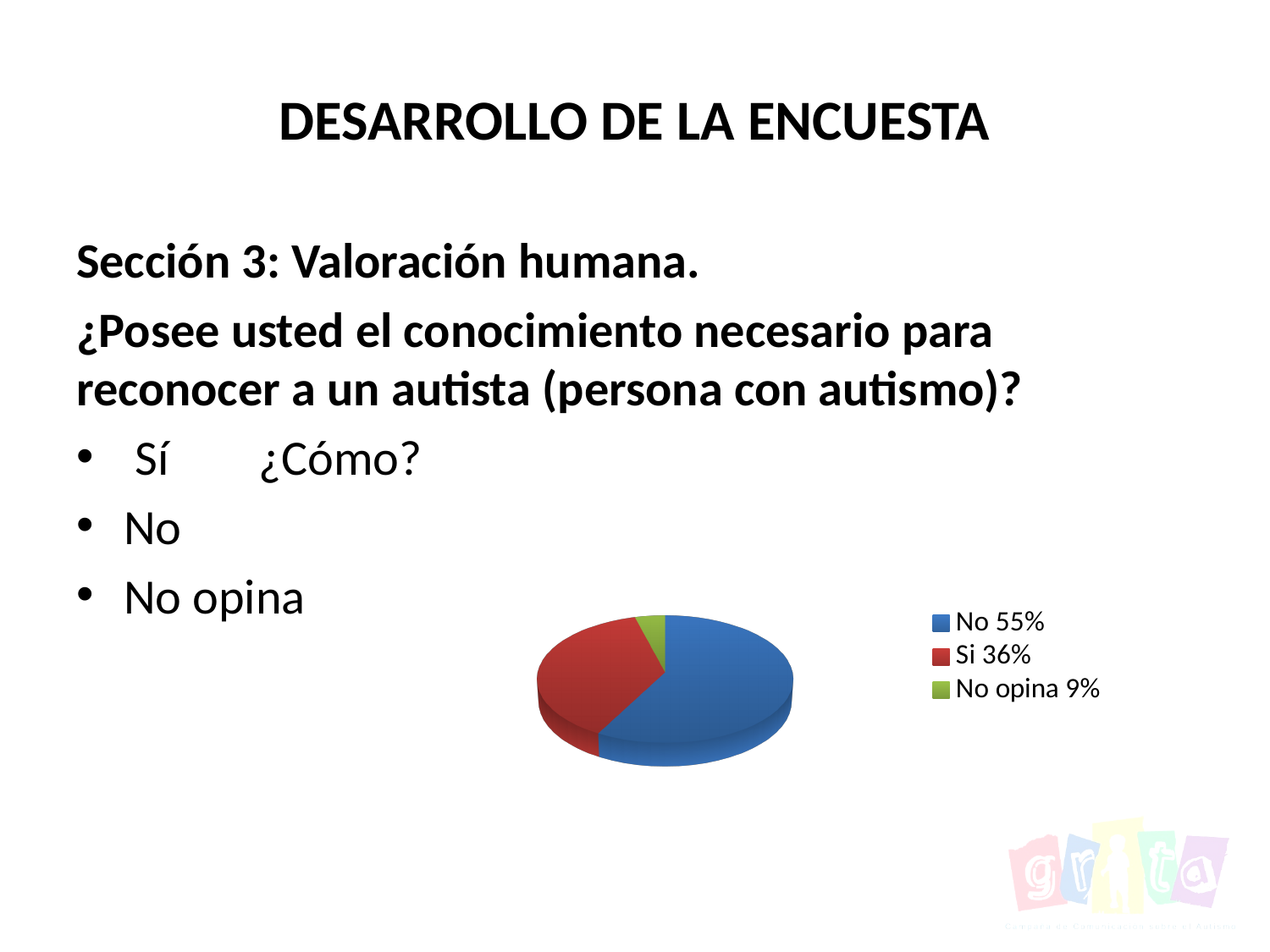
What is the difference in percentage points between "No" and "Si"? 19 What colour is the slice for "No"? blue How many categories does the pie chart show? 3 What percentage does the legend give for "No opina"? 9% Which is larger, the share for "Si" or the share for "No opina"? Si What is the combined share of "Si" and "No opina"? 45% What percentage does the legend give for "No"? 55% What colour is the slice for "No opina"? green Which category has the smallest slice of the pie? No opina What percentage does the legend give for "Si"? 36% What kind of chart is shown on the slide? pie chart Which category has the largest slice of the pie? No